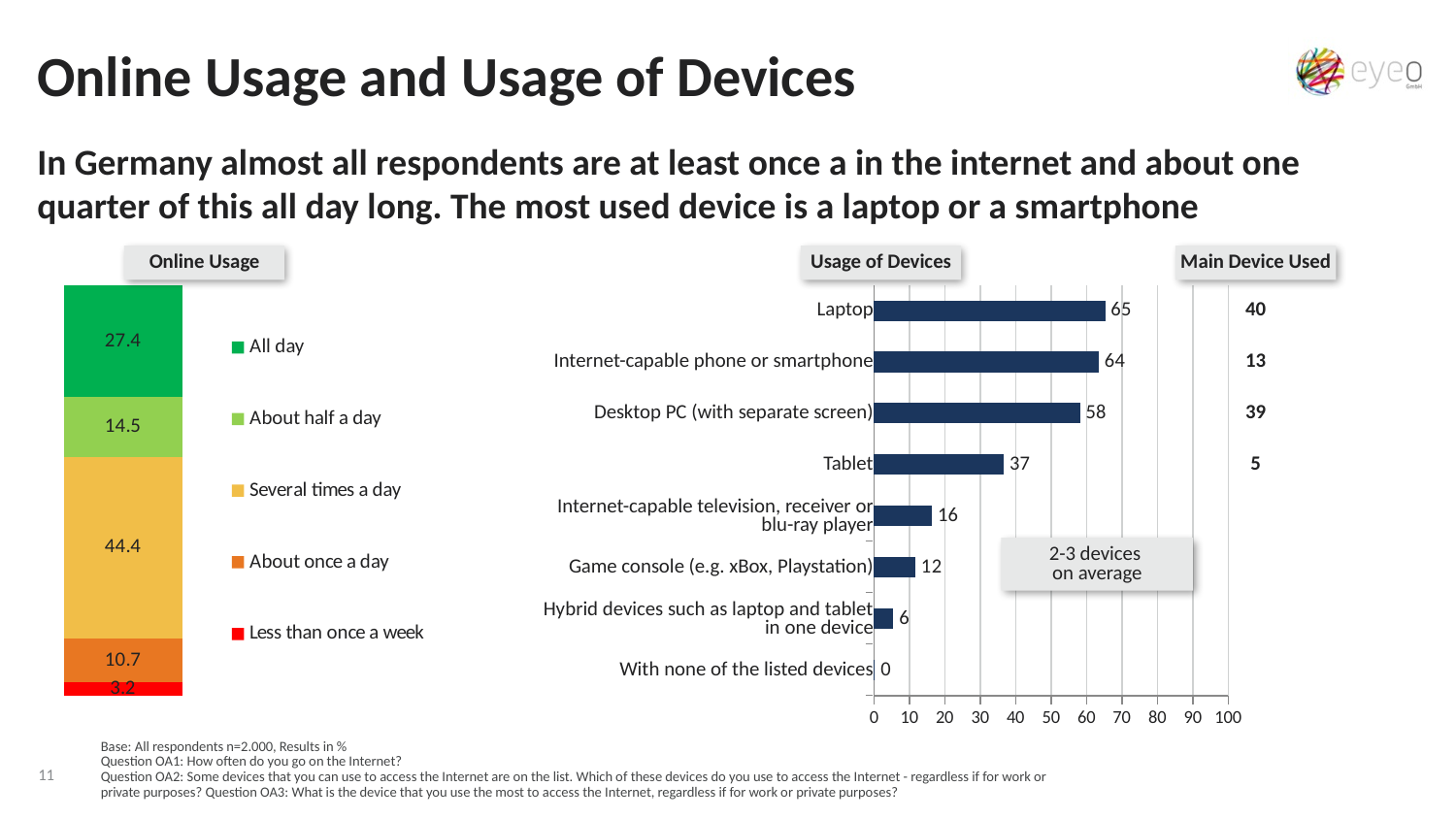
How many device categories are shown in the Usage of Devices chart? 8 In the Usage of Devices chart, what is the value for Laptop? 65 In the Online Usage chart, what is the value for Several times a day? 44.4 In the Usage of Devices chart, which device has the highest value? Laptop In the Usage of Devices chart, which device has the lowest value? With none of the listed devices In the Online Usage chart, what is the value for All day? 27.4 In the Usage of Devices chart, which is larger: the value for Game console (e.g. xBox, Playstation) or the value for Internet-capable television, receiver or blu-ray player? Internet-capable television, receiver or blu-ray player What kind of chart is the Usage of Devices chart? Bar chart In the Usage of Devices chart, what is the value for Tablet? 37 In the Online Usage chart, which category has the smallest value? Less than once a week How many entries does the legend of the Online Usage chart list? 5 In the Usage of Devices chart, what is the difference between the values for Desktop PC (with separate screen) and Tablet? 21